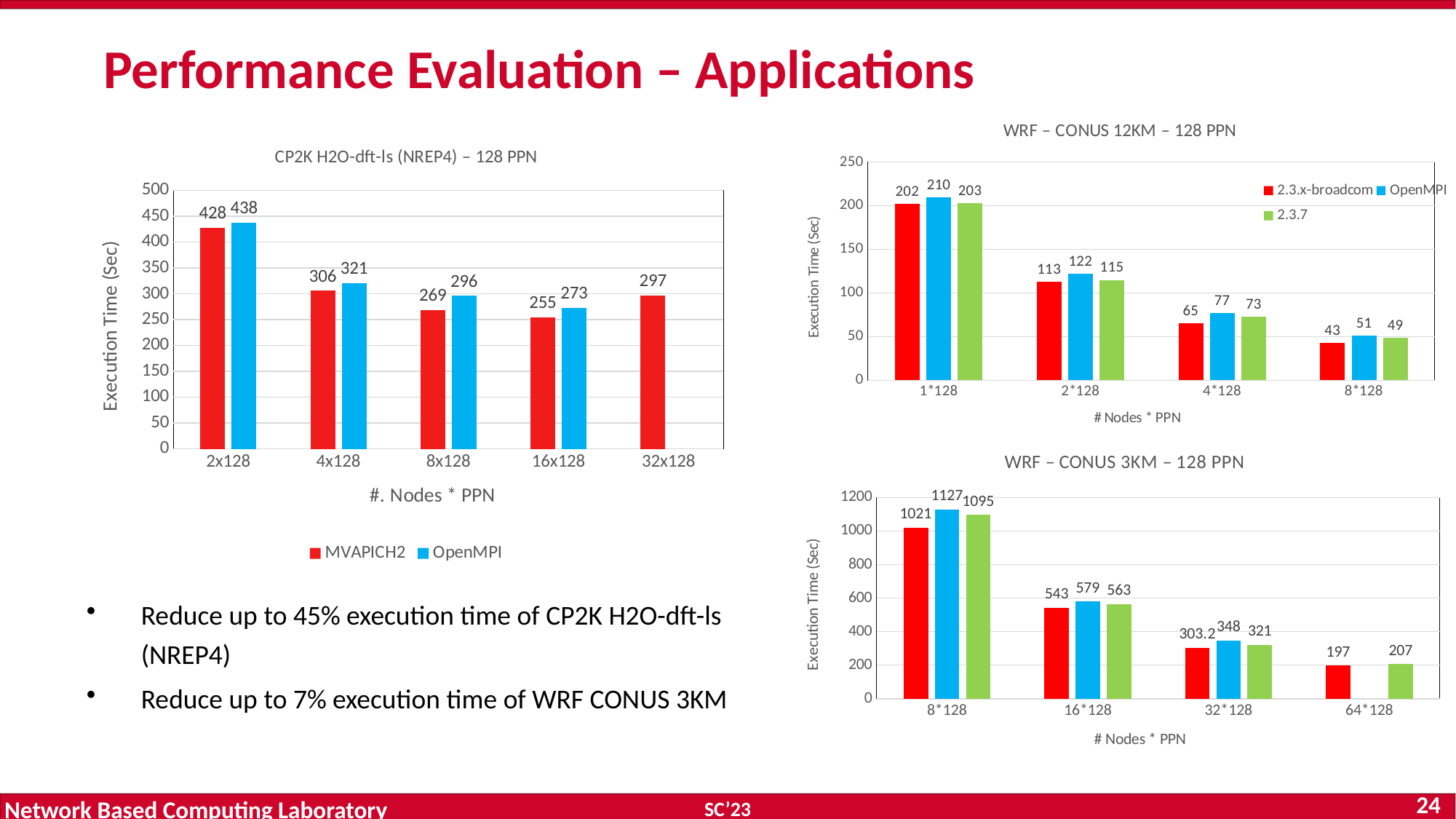
What kind of chart is the WRF – CONUS 3KM – 128 PPN chart? bar chart In the WRF – CONUS 12KM – 128 PPN chart, which node configuration has the lowest execution time for 2.3.x-broadcom? 8*128 In the CP2K H2O-dft-ls (NREP4) – 128 PPN chart, how many series does the legend list? 2 In the CP2K H2O-dft-ls (NREP4) – 128 PPN chart, how many node configurations are shown on the x axis? 5 In the CP2K H2O-dft-ls (NREP4) – 128 PPN chart, what is the difference between the OpenMPI and MVAPICH2 values at 16x128? 18 In the WRF – CONUS 3KM – 128 PPN chart, which is larger at 8*128: the OpenMPI value or the 2.3.7 value? OpenMPI In the WRF – CONUS 12KM – 128 PPN chart, how many series does the legend list? 3 In the WRF – CONUS 12KM – 128 PPN chart, what is the execution time for OpenMPI at 4*128? 77 In the CP2K H2O-dft-ls (NREP4) – 128 PPN chart, what is the execution time for OpenMPI at 8x128? 296 In the WRF – CONUS 12KM – 128 PPN chart, do the execution times rise or fall as the number of nodes increases? fall In the WRF – CONUS 3KM – 128 PPN chart, what is the execution time for 2.3.x-broadcom at 32*128? 303.2 In the CP2K H2O-dft-ls (NREP4) – 128 PPN chart, what is the execution time for MVAPICH2 at 2x128? 428